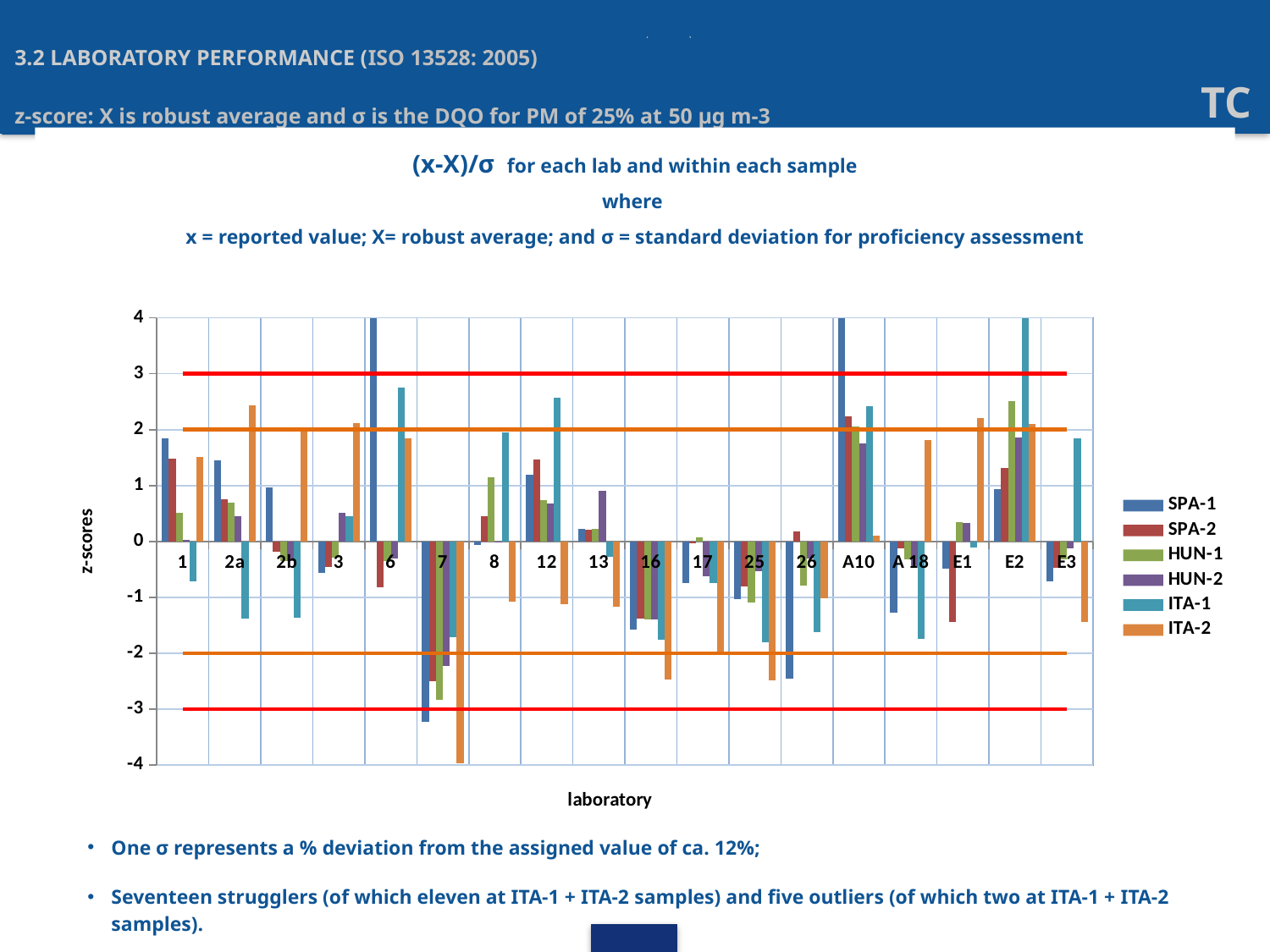
Is the ITA-2 z-score for laboratory 25 greater or less than -2? less What is the label of the vertical axis of the chart? z-scores How many series does the chart legend list? 6 Is the SPA-1 z-score for laboratory 1 greater or less than 1? greater What kind of chart is shown on the slide? bar chart For laboratory 1, which series has the larger z-score, SPA-1 or HUN-1? SPA-1 Is the SPA-1 z-score for laboratory 6 greater or less than 3? greater How many laboratories are shown along the x axis of the chart? 18 What is the label of the horizontal axis of the chart? laboratory